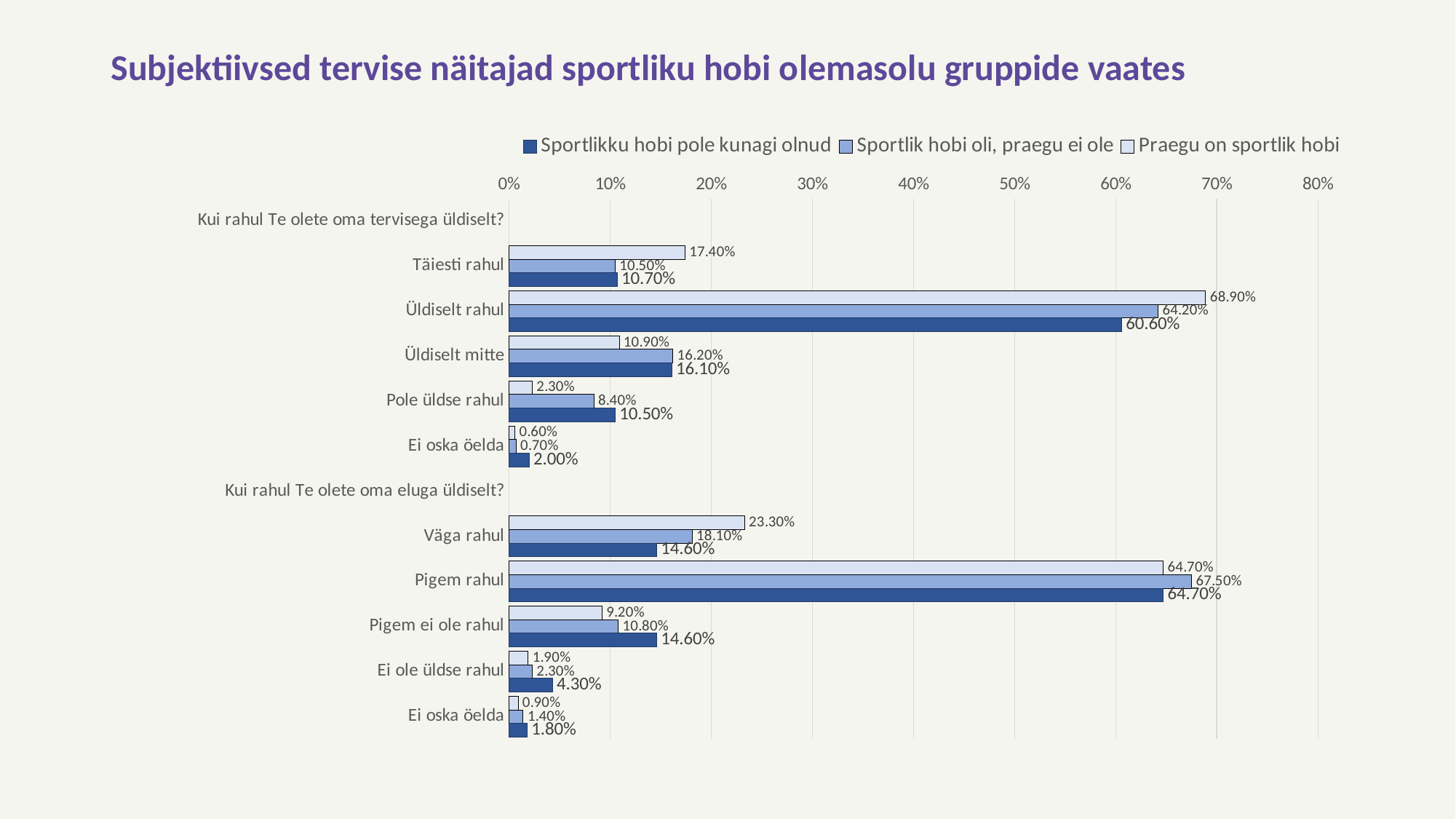
What is the value for "Sportlikku hobi pole kunagi olnud" in the "Üldiselt rahul" category? 60.60% What is the value for "Praegu on sportlik hobi" in the "Täiesti rahul" category under "Kui rahul Te olete oma tervisega üldiselt?"? 17.40% What is the value for "Sportlikku hobi pole kunagi olnud" in the "Ei oska öelda" category under "Kui rahul Te olete oma eluga üldiselt?"? 1.80% How many series does the legend list? 3 What is the difference between "Praegu on sportlik hobi" and "Sportlikku hobi pole kunagi olnud" in the "Üldiselt rahul" category? 8.30% What is the value for "Sportlik hobi oli, praegu ei ole" in the "Pigem rahul" category? 67.50% What kind of chart is shown on the slide? bar chart Which is larger in the "Pigem ei ole rahul" category: "Sportlikku hobi pole kunagi olnud" or "Praegu on sportlik hobi"? Sportlikku hobi pole kunagi olnud Which series has the lowest value in the "Pole üldse rahul" category? Praegu on sportlik hobi Which series has the highest value in the "Väga rahul" category? Praegu on sportlik hobi Is the value for "Praegu on sportlik hobi" in the "Üldiselt rahul" category greater or less than 60%? greater What is the title of the chart? Subjektiivsed tervise näitajad sportliku hobi olemasolu gruppide vaates